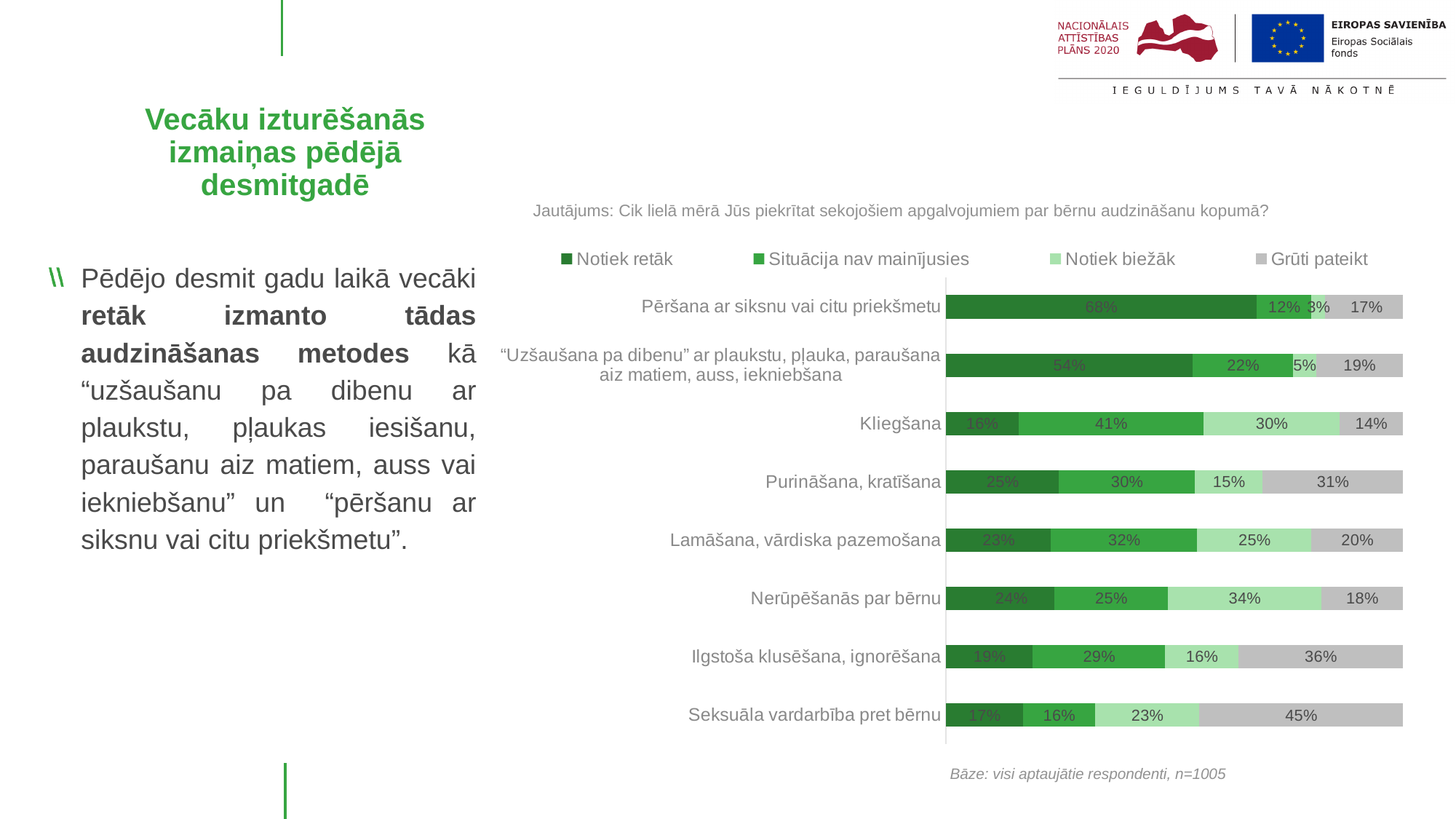
How many series does the chart legend list? 4 Which category has the lowest 'Grūti pateikt' value? Kliegšana What is the 'Notiek biežāk' value for 'Nerūpēšanās par bērnu'? 34% What is the 'Grūti pateikt' value for 'Seksuāla vardarbība pret bērnu'? 45% What type of chart is shown on the slide? Stacked bar chart What is the difference between the 'Notiek retāk' values for 'Pēršana ar siksnu vai citu priekšmetu' and 'Kliegšana'? 52% What is the first series listed in the chart legend? Notiek retāk What is the 'Situācija nav mainījusies' value for 'Kliegšana'? 41% Which category has the highest 'Notiek retāk' value? Pēršana ar siksnu vai citu priekšmetu How many categories are plotted in the chart? 8 Which is larger: the 'Notiek biežāk' value for 'Kliegšana' or for 'Purināšana, kratīšana'? Kliegšana What is the 'Notiek retāk' value for 'Pēršana ar siksnu vai citu priekšmetu'? 68%